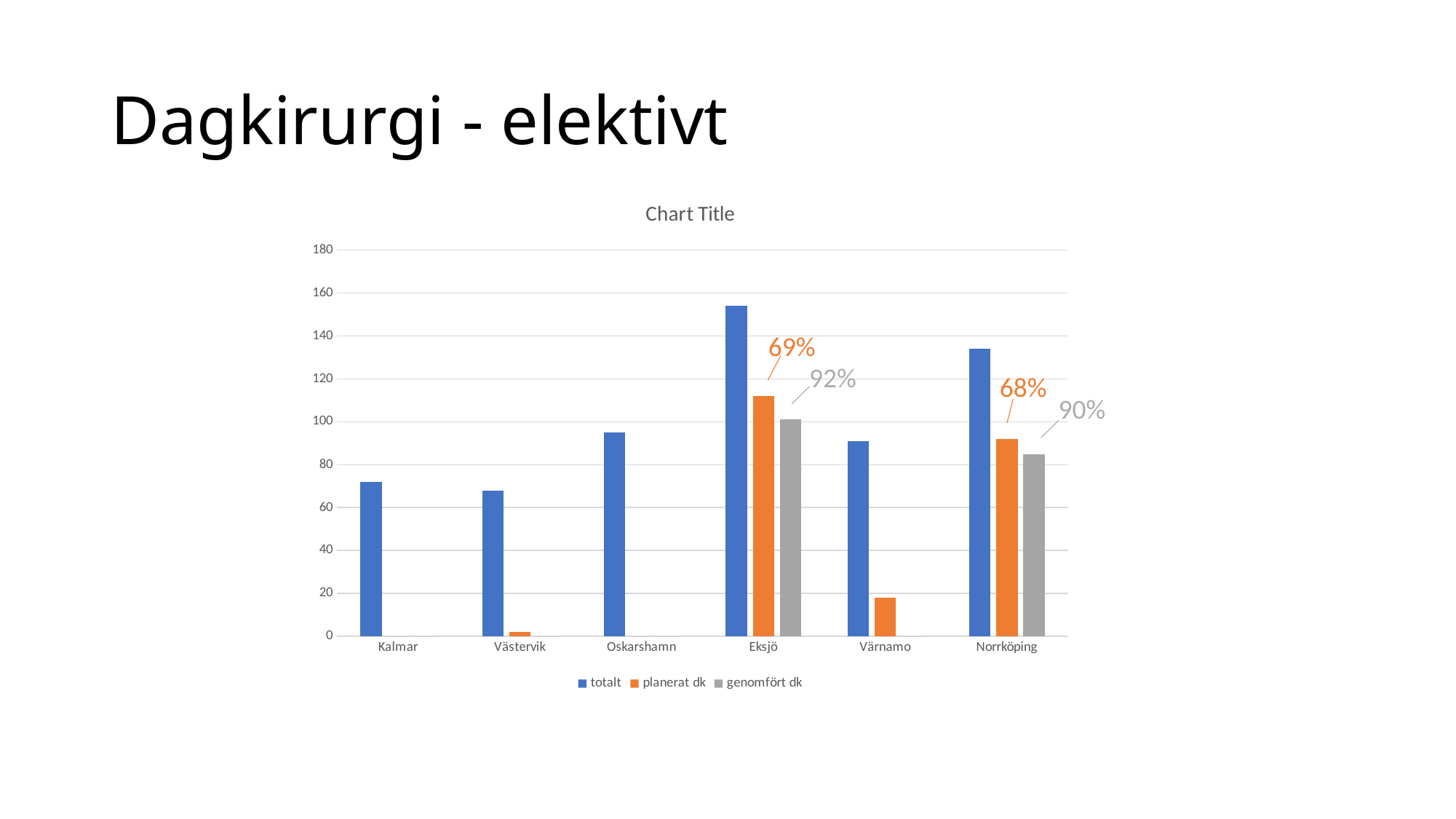
Which has the larger planerat dk value, Eksjö or Norrköping? Eksjö Is the totalt value for Eksjö greater or less than 140? greater Is the totalt value for Norrköping greater or less than 120? greater What kind of chart is shown on the slide? bar chart What percentage annotation is shown next to the planerat dk bar for Norrköping? 68% Which category has the highest value for the totalt series? Eksjö Is the planerat dk value for Eksjö greater or less than 100? greater How many series does the chart's legend list? 3 How many categories are shown on the x axis of the chart? 6 Which has the larger totalt value, Kalmar or Oskarshamn? Oskarshamn